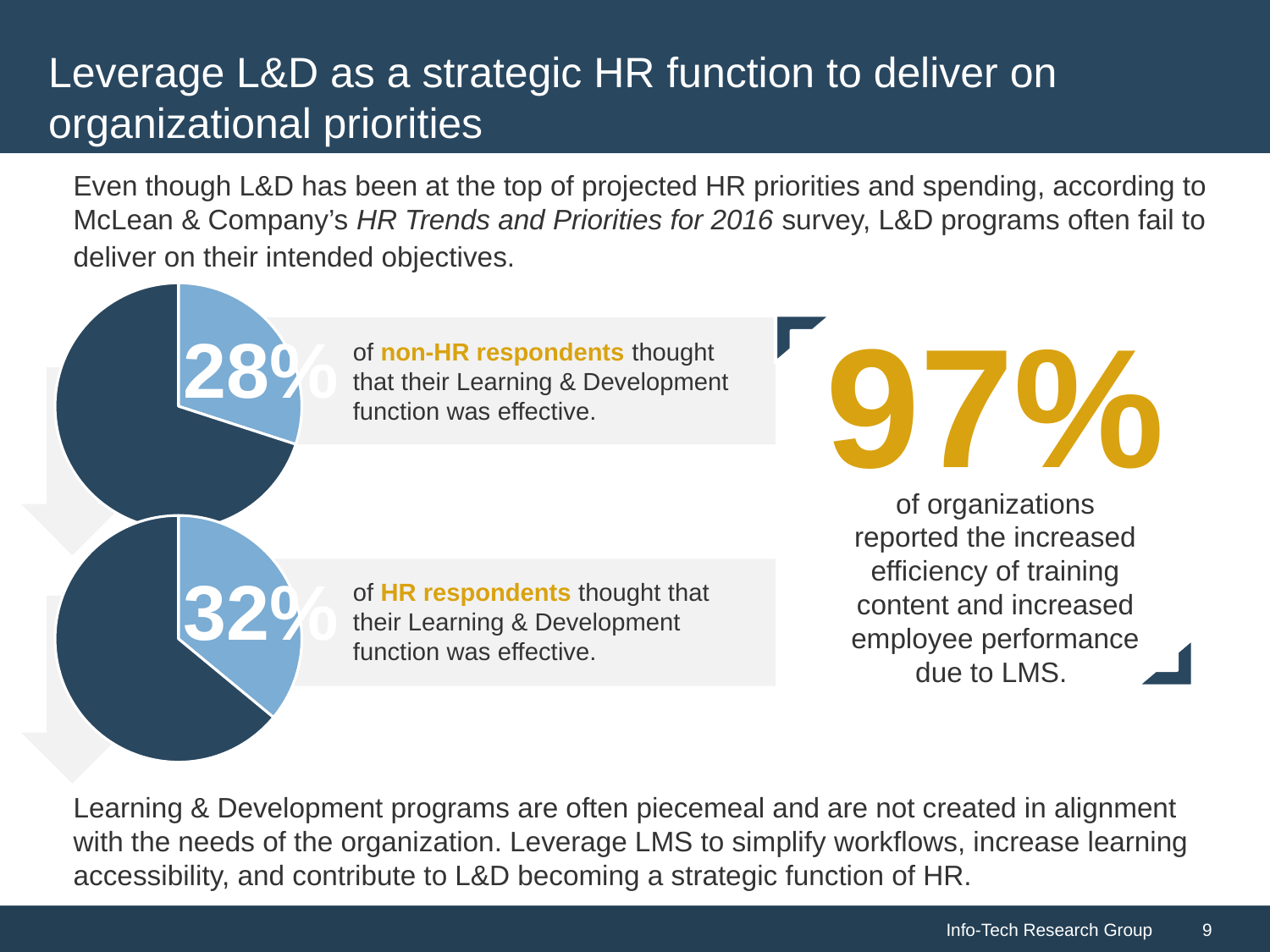
In the bottom pie chart, what colour is the larger slice representing the remainder of HR respondents? dark blue In the top pie chart, is the highlighted slice for non-HR respondents greater or less than 50% of the pie? less What kind of chart is used to show the 28% of non-HR respondents who thought their Learning & Development function was effective? pie chart What share of the bottom pie chart is taken up by the slice for HR respondents who thought their L&D function was effective? 32% In the top pie chart, what percentage of non-HR respondents thought that their Learning & Development function was effective? 28% By how many percentage points does the share of HR respondents who thought their L&D function was effective (bottom pie chart) exceed the share of non-HR respondents (top pie chart)? 4 percentage points In the bottom pie chart, is the highlighted slice for HR respondents greater or less than 50% of the pie? less Which group had a larger share of respondents who thought their Learning & Development function was effective, HR respondents or non-HR respondents? HR respondents In the bottom pie chart, what percentage of HR respondents thought that their Learning & Development function was effective? 32% How many pie charts are shown on the slide? 2 How many slices does each pie chart on the slide have? 2 In the top pie chart, what colour is the slice representing the 28% of non-HR respondents? light blue